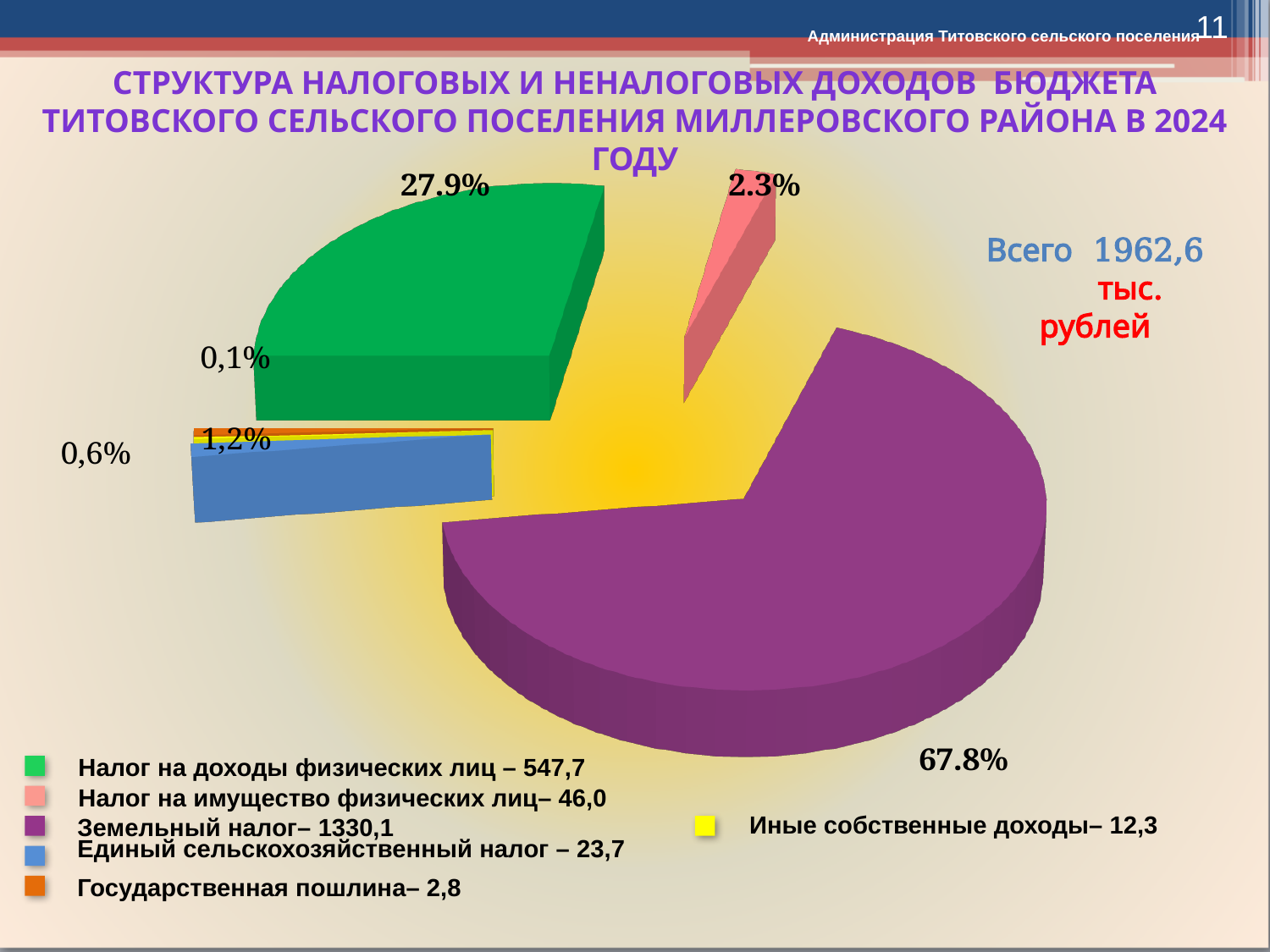
What value is given in the legend for Земельный налог? 1330,1 Which is larger: the slice for Налог на доходы физических лиц or the slice for Налог на имущество физических лиц? Налог на доходы физических лиц What share of the pie does Земельный налог have? 67.8% What share of the pie does Налог на имущество физических лиц have? 2.3% What share of the pie does Налог на доходы физических лиц have? 27.9% Which category has the largest slice of the pie? Земельный налог What colour is the slice for Земельный налог? purple What value is given in the legend for Иные собственные доходы? 12,3 What kind of chart is shown on the slide? pie chart What value is given in the legend for Единый сельскохозяйственный налог? 23,7 What total (Всего) is stated on the slide? 1962,6 тыс. рублей How many categories does the legend list? 6